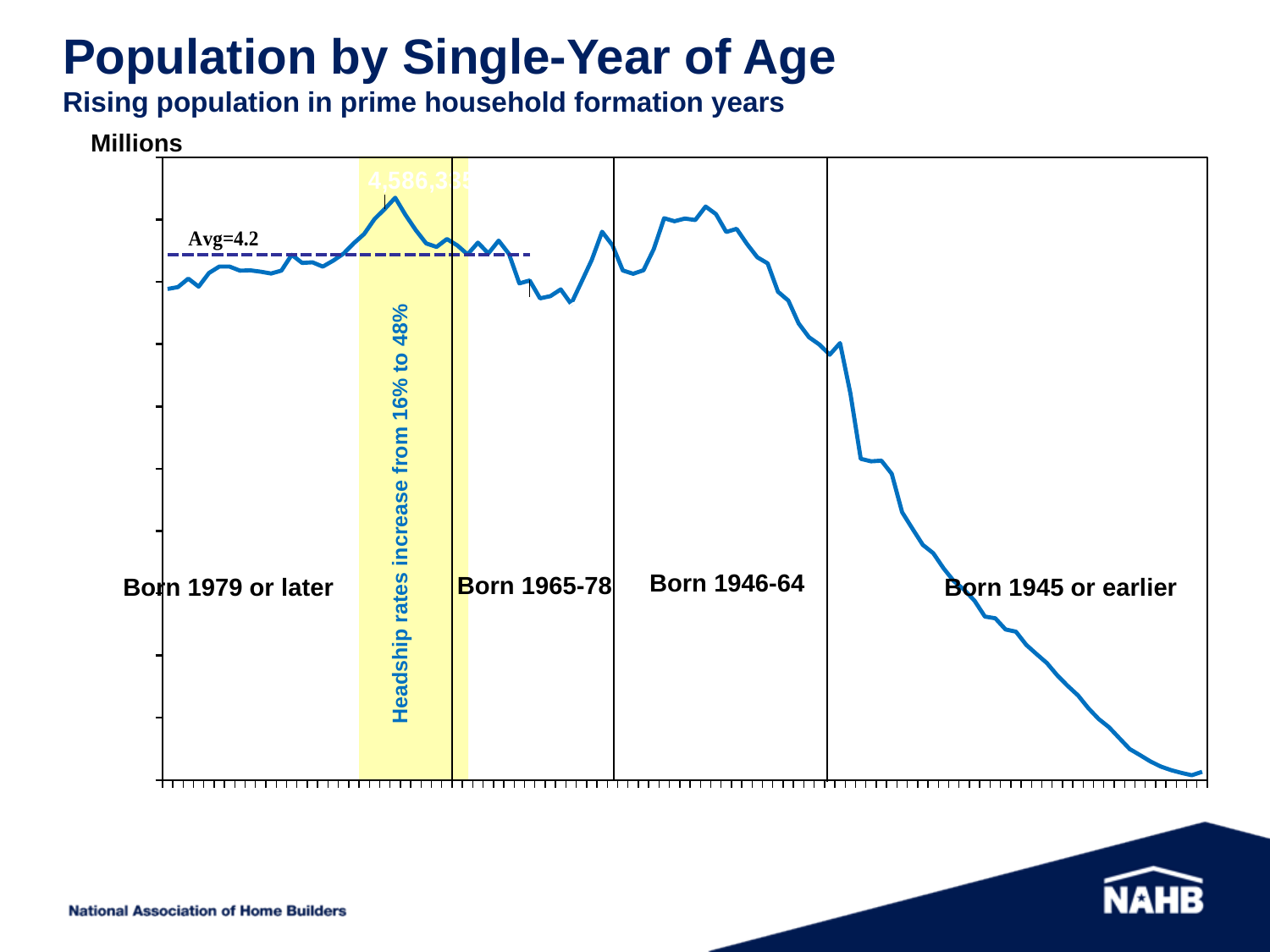
What average value is marked by the dashed horizontal line on the chart? 4.2 According to the annotation in the yellow band, headship rates increase from what percentage to what percentage? from 16% to 48% Does the population line rise or fall across the 'Born 1945 or earlier' section of the chart? fall Which birth-cohort group is labelled at the far left of the chart? Born 1979 or later How many birth-cohort groups are labelled along the chart? 4 What unit is the vertical axis of the chart measured in? Millions What kind of chart is shown on the slide? line chart Is the population at the far right end of the line above or below the Avg=4.2 dashed line? below Which birth-cohort group is labelled at the far right of the chart? Born 1945 or earlier Which birth-cohort label appears between 'Born 1965-78' and 'Born 1945 or earlier'? Born 1946-64 What is the title of the chart on the slide? Population by Single-Year of Age Which birth-cohort section contains the lowest point of the population line? Born 1945 or earlier